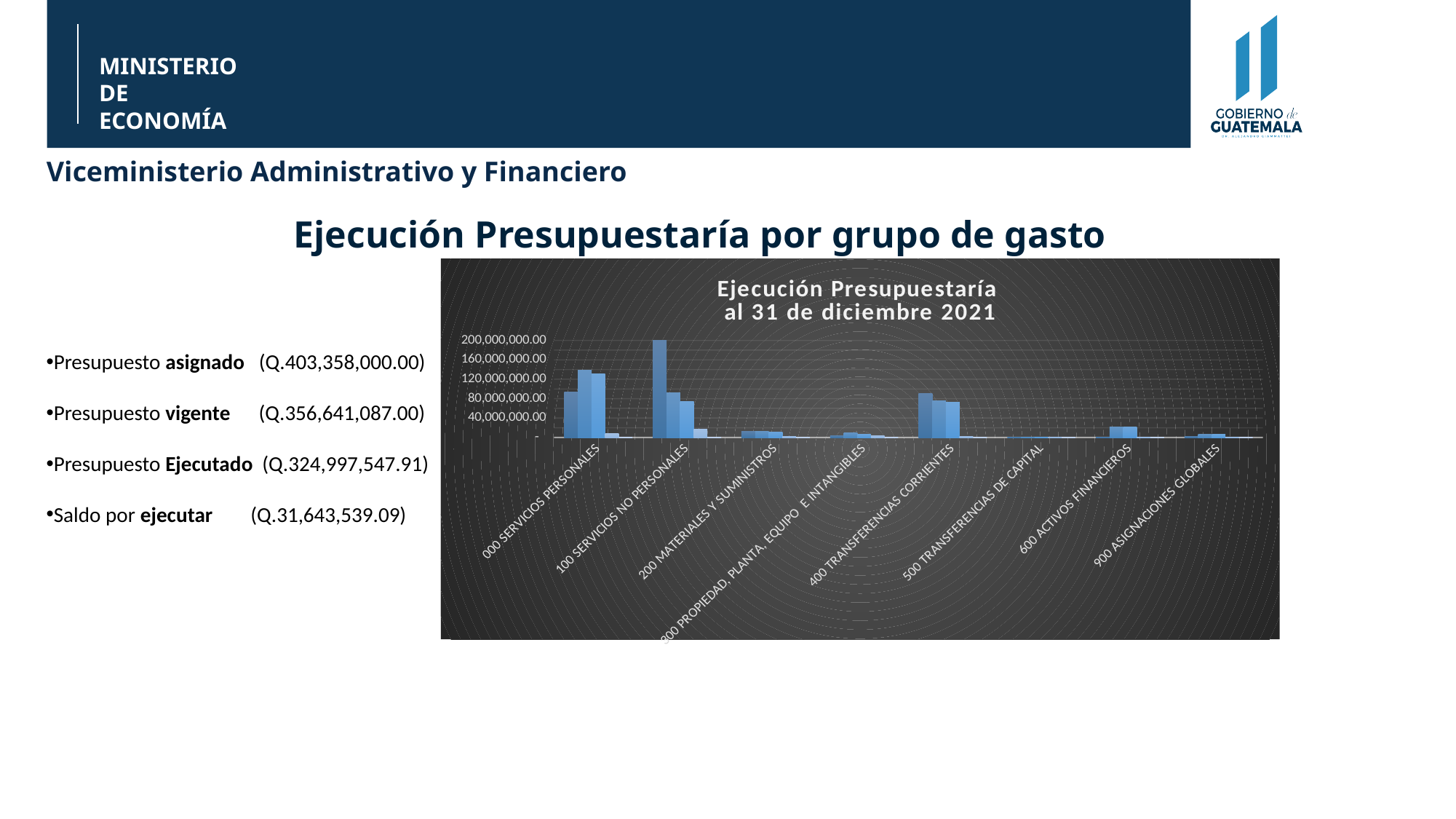
Is the tallest bar for 400 TRANSFERENCIAS CORRIENTES greater or less than 40,000,000.00? greater Which has a taller tallest bar: 200 MATERIALES Y SUMINISTROS or 600 ACTIVOS FINANCIEROS? 600 ACTIVOS FINANCIEROS Is the tallest bar for 000 SERVICIOS PERSONALES greater or less than 120,000,000.00? greater What is the title of the chart? Ejecución Presupuestaría al 31 de diciembre 2021 Is the tallest bar for 400 TRANSFERENCIAS CORRIENTES greater or less than 120,000,000.00? less Which category has the tallest bar in the chart? 100 SERVICIOS NO PERSONALES What is the highest value labelled on the vertical axis of the chart? 200,000,000.00 How many expense-group categories are shown on the x axis of the chart? 8 What kind of chart is shown on the slide? bar chart Which has a taller tallest bar: 000 SERVICIOS PERSONALES or 400 TRANSFERENCIAS CORRIENTES? 000 SERVICIOS PERSONALES